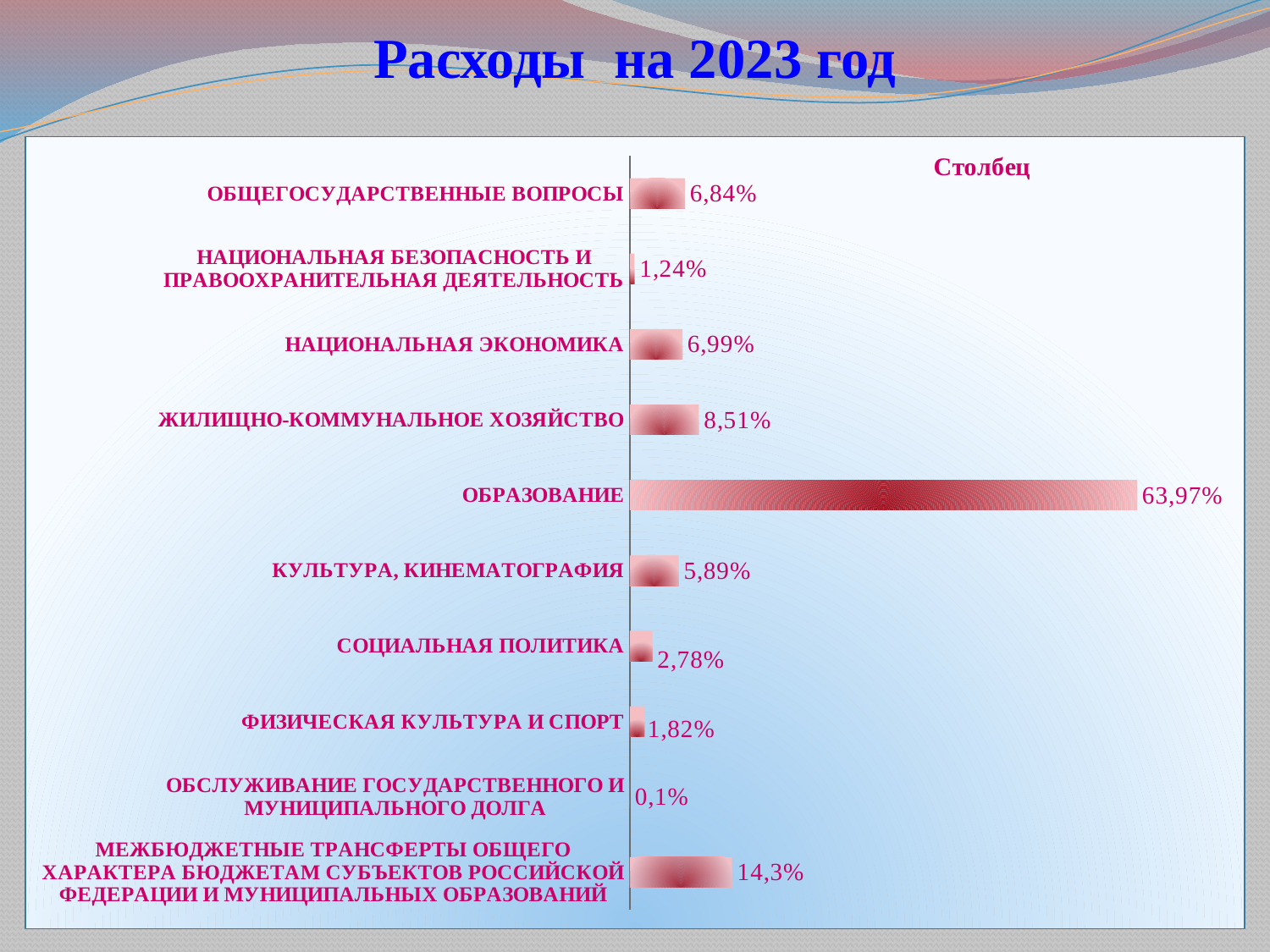
What is the value for ОБРАЗОВАНИЕ? 63,97% What is the value for ЖИЛИЩНО-КОММУНАЛЬНОЕ ХОЗЯЙСТВО? 8,51% Which category has the highest value? ОБРАЗОВАНИЕ How many categories are shown in the chart? 10 What is the value for ОБСЛУЖИВАНИЕ ГОСУДАРСТВЕННОГО И МУНИЦИПАЛЬНОГО ДОЛГА? 0,1% Which is larger, the value for ОБЩЕГОСУДАРСТВЕННЫЕ ВОПРОСЫ or the value for КУЛЬТУРА, КИНЕМАТОГРАФИЯ? ОБЩЕГОСУДАРСТВЕННЫЕ ВОПРОСЫ What is the title of the slide? Расходы на 2023 год What is the value for МЕЖБЮДЖЕТНЫЕ ТРАНСФЕРТЫ ОБЩЕГО ХАРАКТЕРА БЮДЖЕТАМ СУБЪЕКТОВ РОССИЙСКОЙ ФЕДЕРАЦИИ И МУНИЦИПАЛЬНЫХ ОБРАЗОВАНИЙ? 14,3% What is the difference between the values for ЖИЛИЩНО-КОММУНАЛЬНОЕ ХОЗЯЙСТВО and НАЦИОНАЛЬНАЯ ЭКОНОМИКА? 1,52% What kind of chart is shown on the slide? Bar chart Which category has the lowest value? ОБСЛУЖИВАНИЕ ГОСУДАРСТВЕННОГО И МУНИЦИПАЛЬНОГО ДОЛГА